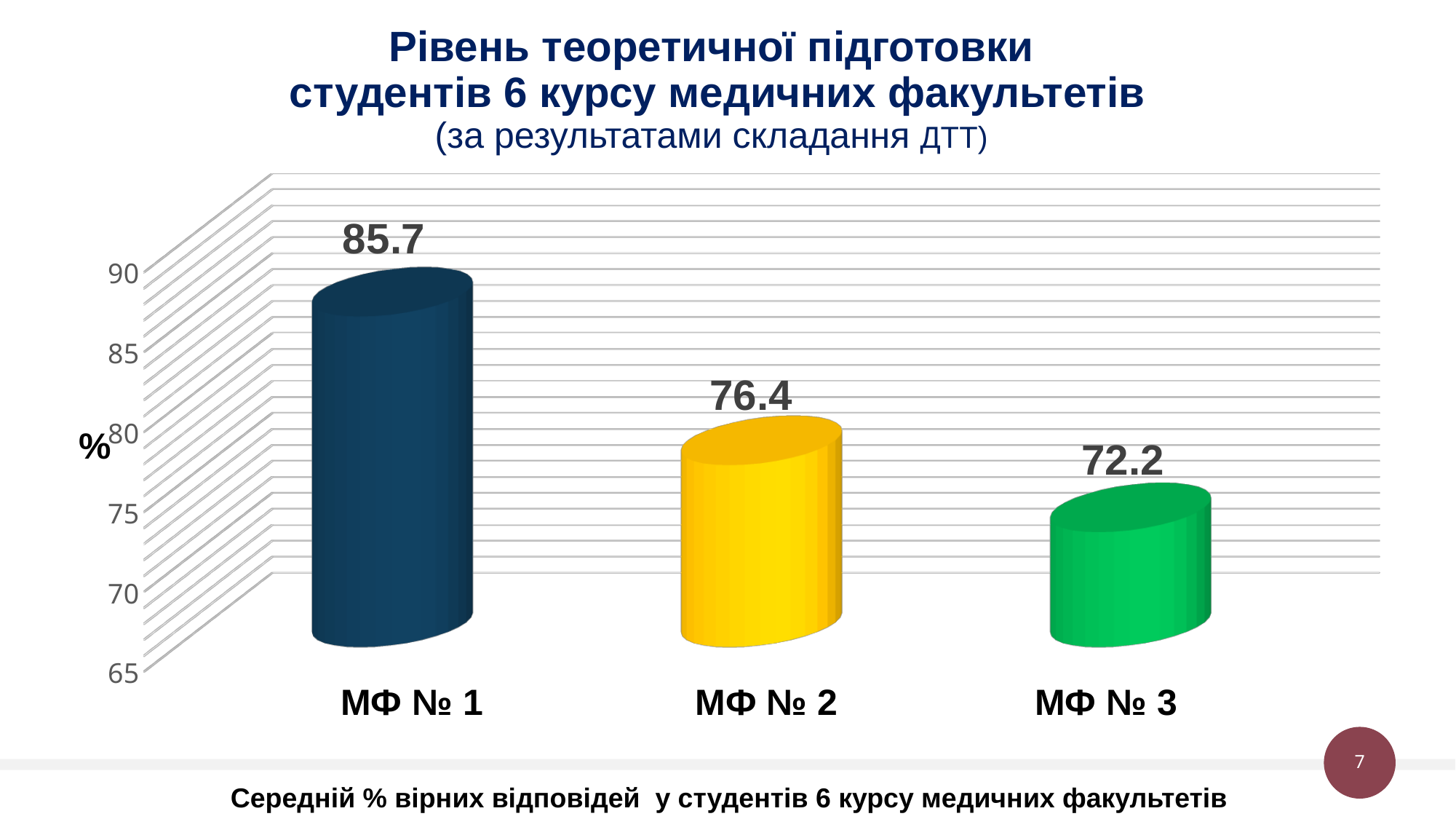
Which faculty has the highest value? МФ № 1 Which is larger, the value for МФ № 2 or МФ № 3? МФ № 2 Is the value for МФ № 1 greater or less than 80? greater Do the values rise or fall from МФ № 1 to МФ № 3? fall What kind of chart is shown on the slide? bar chart What is the value for МФ № 2? 76.4 What is the value for МФ № 1? 85.7 Which faculty has the lowest value? МФ № 3 What is the difference between the values for МФ № 2 and МФ № 3? 4.2 What is the value for МФ № 3? 72.2 How many faculties are shown on the chart? 3 What is the difference between the values for МФ № 1 and МФ № 3? 13.5